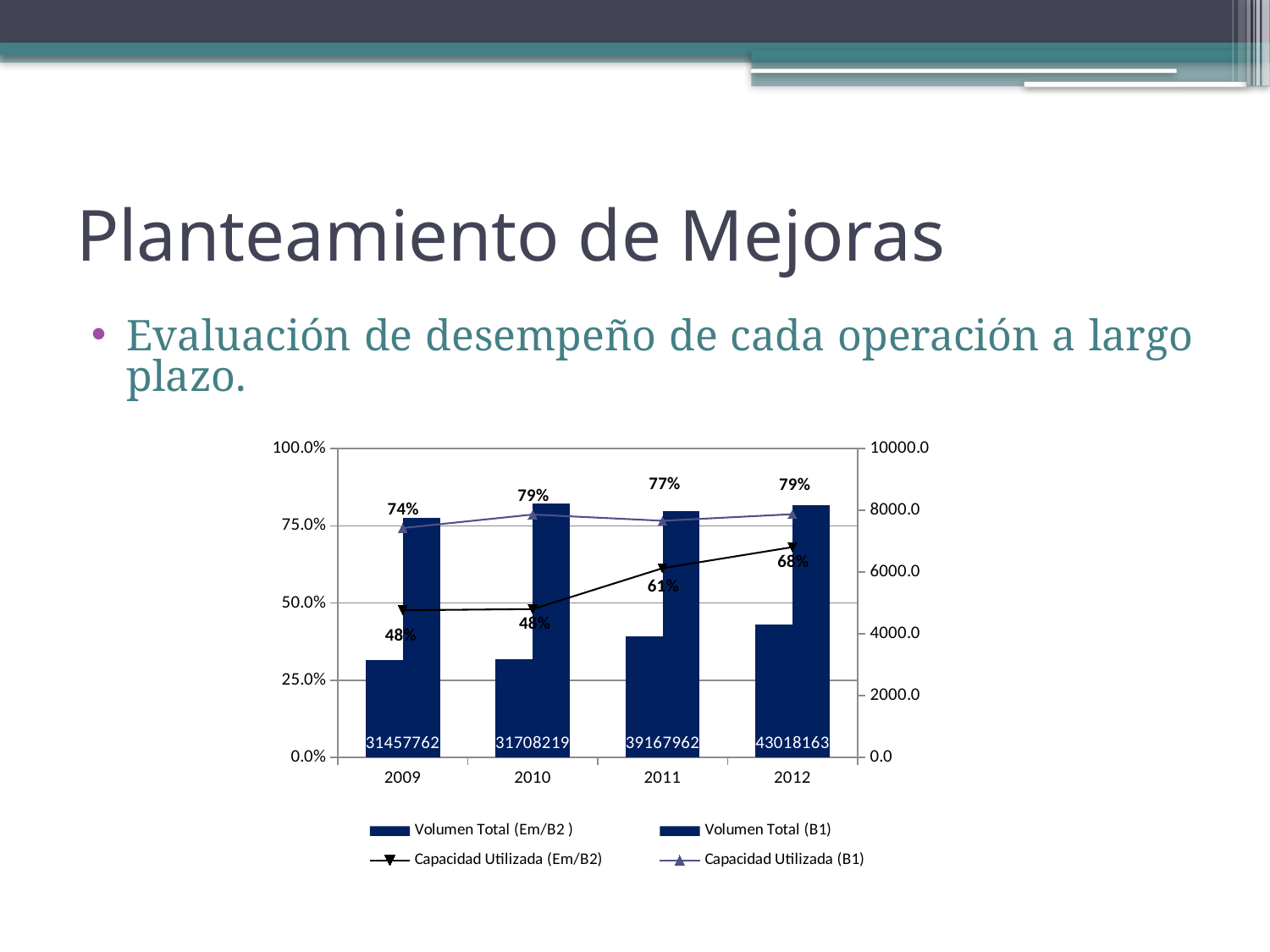
How many series does the legend list? 4 What numeric label is printed at the bottom of the bars for 2012? 43018163 Does Capacidad Utilizada (Em/B2) rise or fall from 2009 to 2012? Rises What kind of chart is shown on the slide? A combination bar and line chart What is the difference between Capacidad Utilizada (B1) and Capacidad Utilizada (Em/B2) in 2012? 11 percentage points Is the Volumen Total (B1) bar for 2012 greater or less than 6000.0 on the right axis? greater In which year is Capacidad Utilizada (B1) lowest? 2009 What is the Capacidad Utilizada (Em/B2) value for 2011? 61% In which year is Capacidad Utilizada (Em/B2) highest? 2012 In 2010, which is larger: Capacidad Utilizada (B1) or Capacidad Utilizada (Em/B2)? Capacidad Utilizada (B1) What is the Capacidad Utilizada (B1) value for 2009? 74% How many years are shown on the x axis? 4